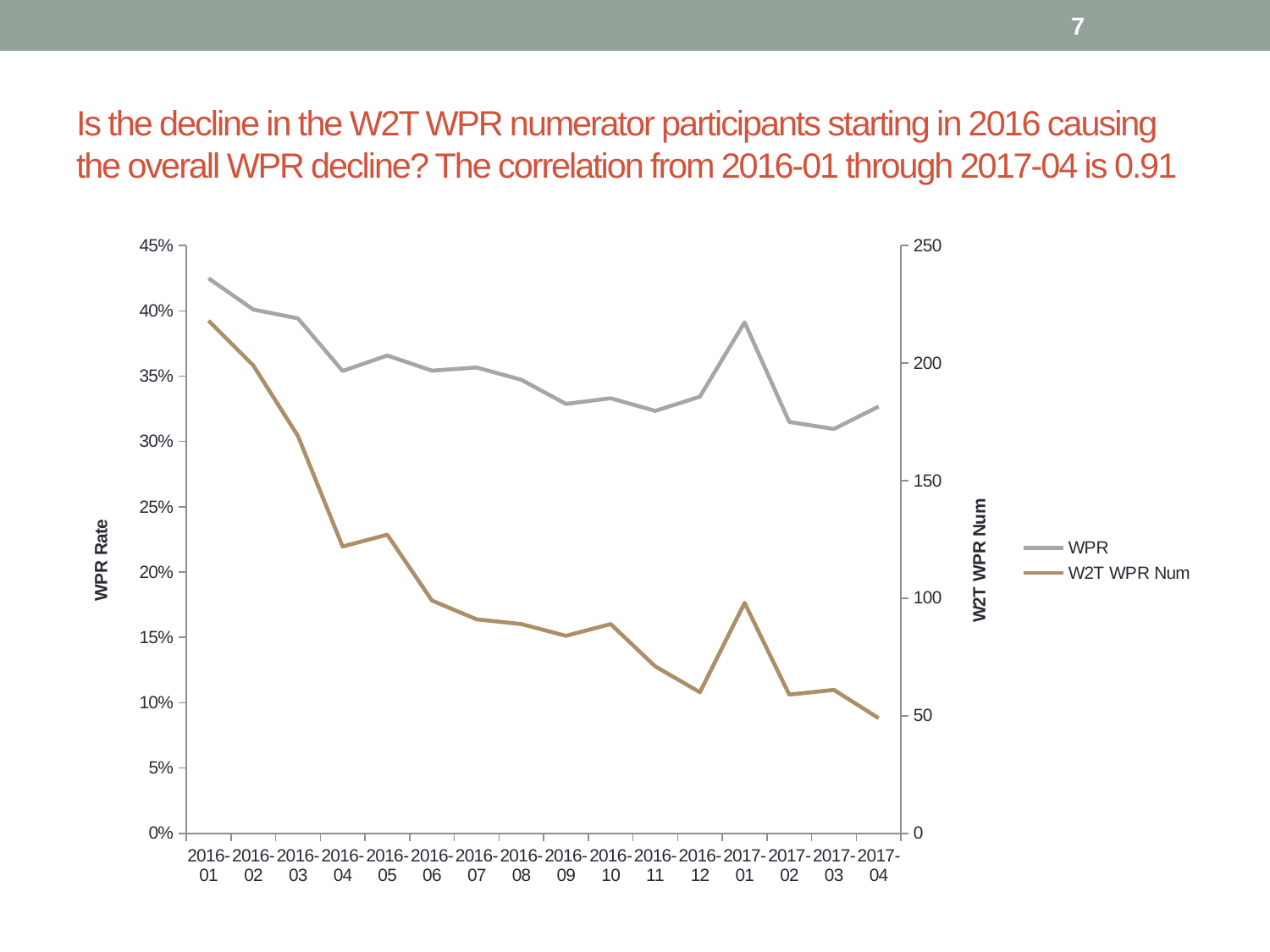
How many months are plotted along the x axis? 16 Which is larger for W2T WPR Num, the value for 2017-01 or the value for 2017-02? 2017-01 Does the W2T WPR Num series generally rise or fall from 2016-01 to 2017-04? Fall Is the W2T WPR Num value for 2016-12 greater or less than 100? less What is the title of the left vertical axis? WPR Rate What kind of chart is shown on the slide? Line chart In which month is the W2T WPR Num series at its lowest? 2017-04 In which month is the WPR series at its highest? 2016-01 Does the WPR series generally rise or fall from 2016-01 to 2017-04? Fall Is the W2T WPR Num value for 2016-01 greater or less than 200? greater How many series does the legend list? 2 Is the WPR value for 2016-01 greater or less than 40%? greater